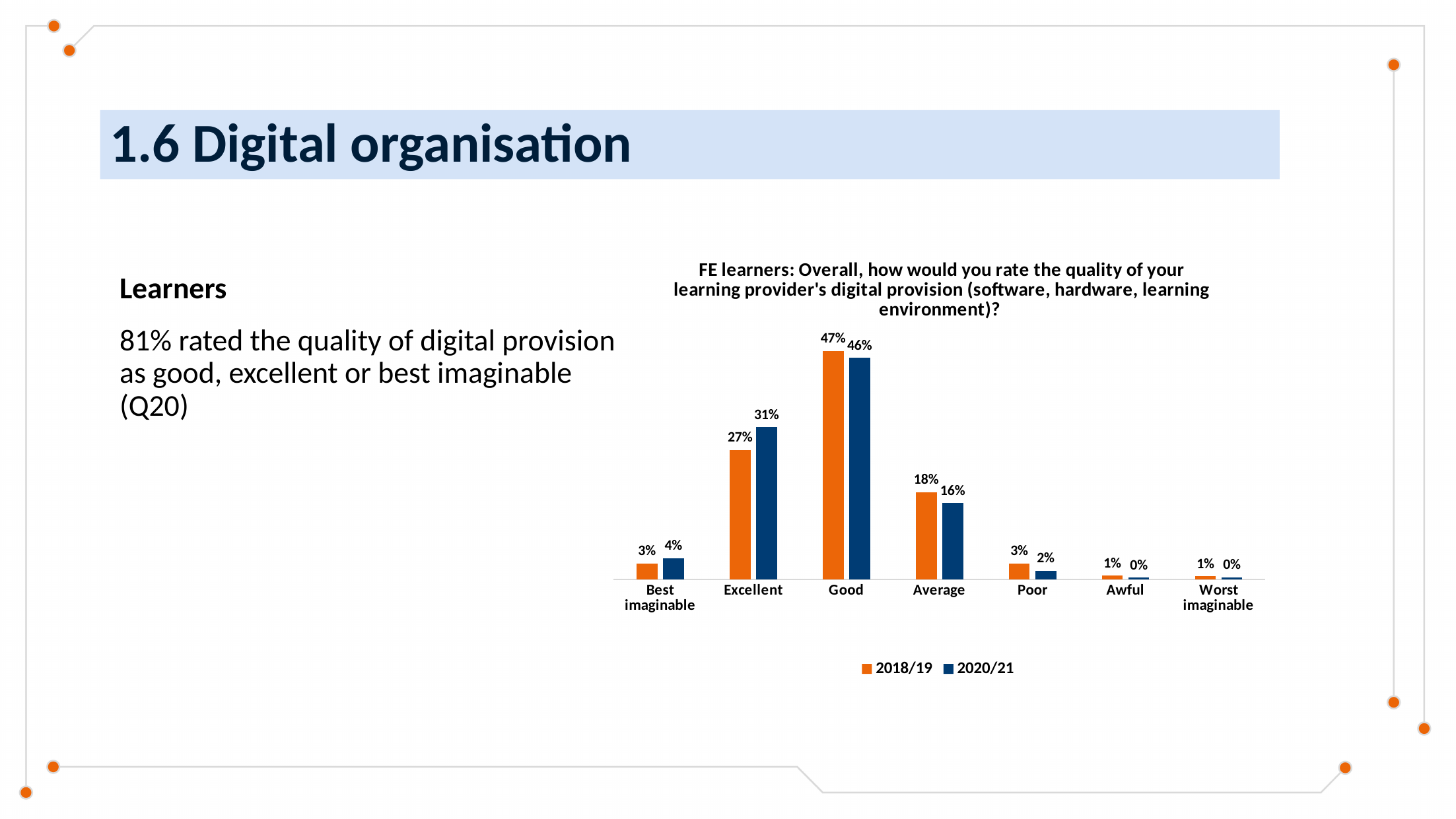
How many rating categories are shown on the x axis? 7 Which rating category has the highest value in the 2020/21 series? Good What kind of chart is shown on the slide? Bar chart What is the value for Poor in the 2018/19 series? 3% What is the difference between the Good and Excellent values in 2018/19? 20% What percentage of FE learners rated digital provision as Excellent in 2020/21? 31% How many series does the legend list? 2 Which series is shown in orange in the legend? 2018/19 What percentage of FE learners rated digital provision as Good in 2018/19? 47% Which is larger for Average: the 2018/19 value or the 2020/21 value? 2018/19 What is the difference between the 2018/19 and 2020/21 values for Excellent? 4% What is the value for Average in the 2020/21 series? 16%